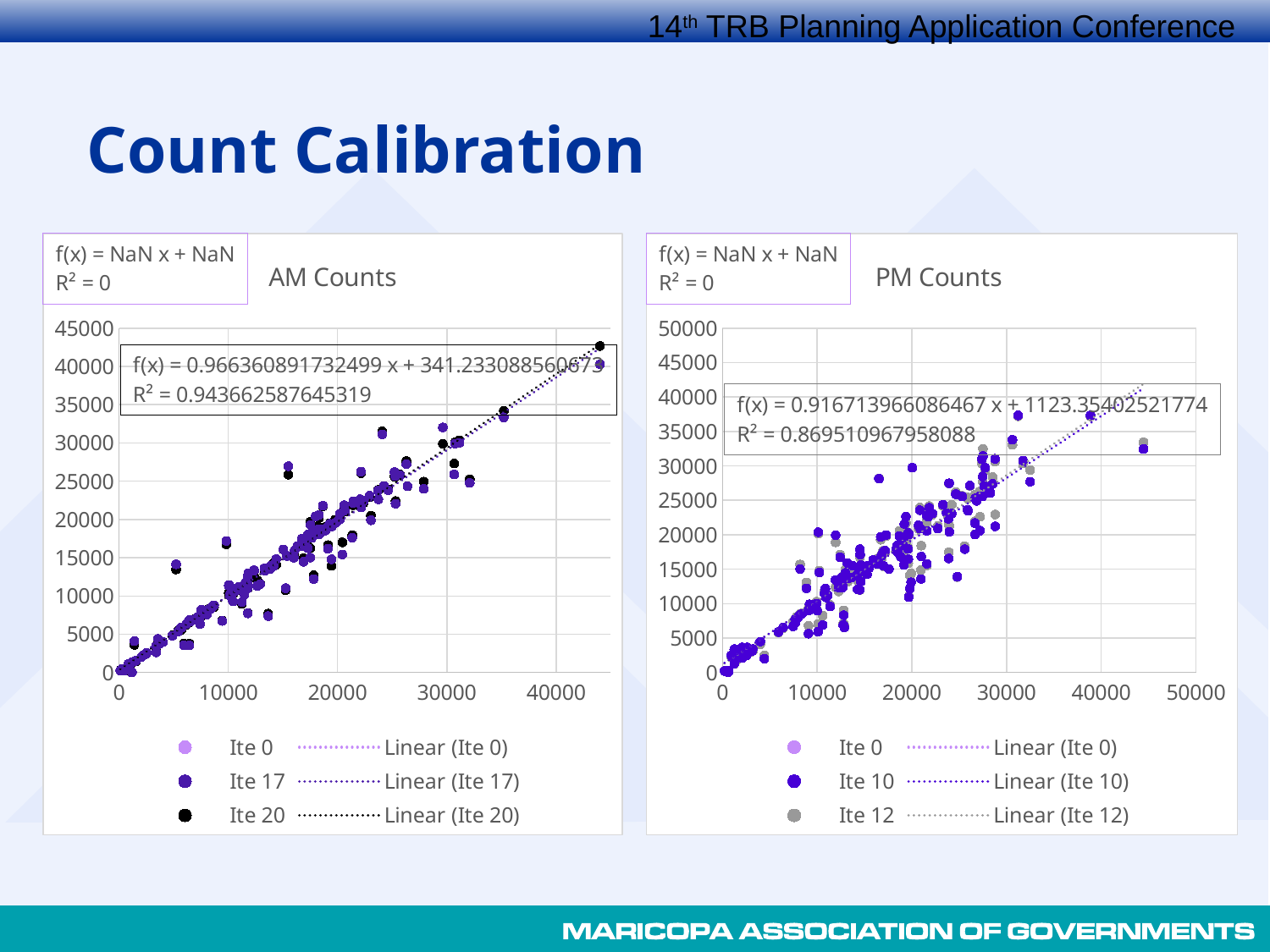
What kind of chart is the PM Counts chart? scatter chart Which chart has the higher R² value for its fitted trendline, AM Counts or PM Counts? AM Counts What is the highest tick value on the y axis of the PM Counts chart? 50000 What kind of chart is the AM Counts chart? scatter chart In the AM Counts chart, how many entries does the legend list? 6 In the AM Counts chart, what is the slope of the fitted line f(x) shown inside the plot area? 0.966360891732499 In the PM Counts chart, what is the R² value shown for the fitted trendline inside the plot area? 0.869510967958088 In the PM Counts chart, how many 'Ite' data series does the legend list (excluding the linear trendlines)? 3 In the PM Counts chart, what is the intercept of the fitted line f(x) shown inside the plot area? 1123.35402521774 In the PM Counts chart, do the plotted values generally rise or fall as x increases? rise In the AM Counts chart, what is the R² value shown for the fitted trendline inside the plot area? 0.943662587645319 Which series in the AM Counts legend is shown in black? Ite 20